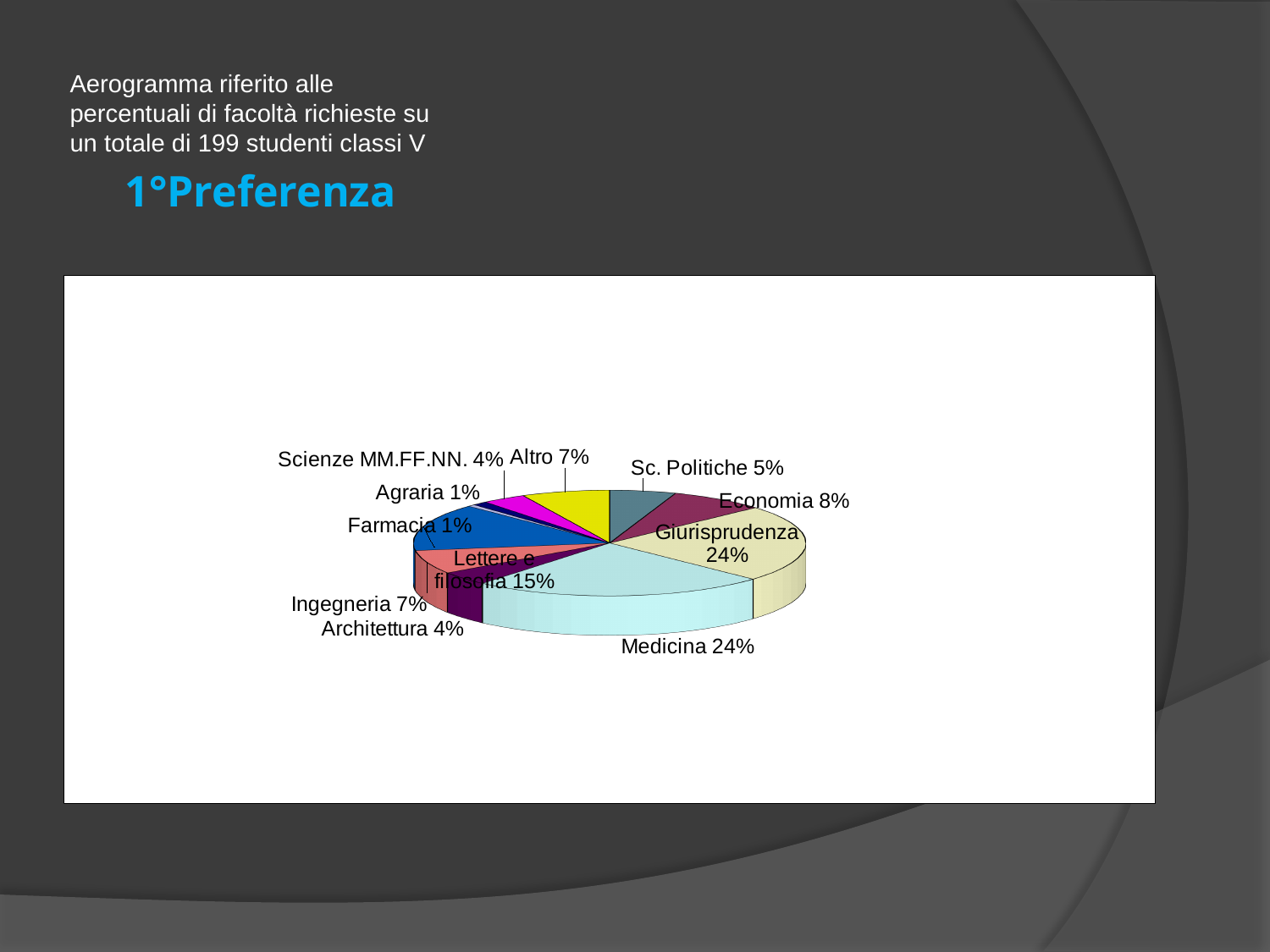
What is the difference between the share for Lettere e filosofia and the share for Economia? 7% What share of the pie does Altro represent? 7% What percentage is shown for Lettere e filosofia? 15% What kind of chart is shown on the slide? pie chart What is the title shown above the chart on the slide? 1°Preferenza What percentage is shown for Medicina? 24% What percentage is shown for Economia? 8% What percentage is shown for Sc. Politiche? 5% What percentage is shown for Farmacia? 1% What percentage is shown for Giurisprudenza? 24% How many slices does the pie chart have? 11 Which is larger, the share for Ingegneria or the share for Architettura? Ingegneria